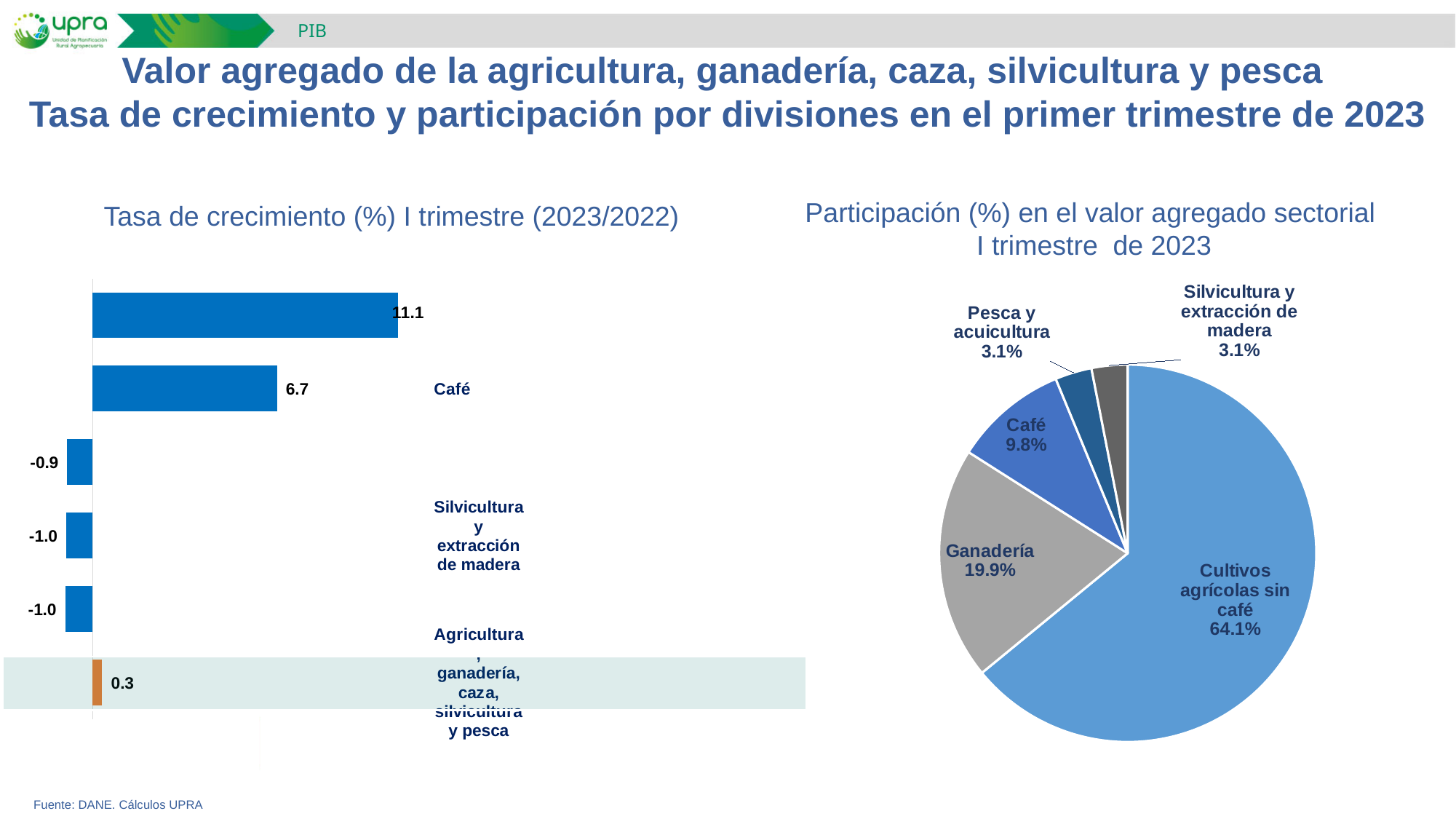
In the pie chart 'Participación (%) en el valor agregado sectorial I trimestre de 2023', what share does 'Cultivos agrícolas sin café' have? 64.1% In the pie chart 'Participación (%) en el valor agregado sectorial I trimestre de 2023', what is the share of 'Ganadería'? 19.9% In the pie chart 'Participación (%) en el valor agregado sectorial I trimestre de 2023', which category has the largest share? Cultivos agrícolas sin café In the pie chart 'Participación (%) en el valor agregado sectorial I trimestre de 2023', which has a larger share, 'Ganadería' or 'Café'? Ganadería In the pie chart 'Participación (%) en el valor agregado sectorial I trimestre de 2023', what is the difference in percentage points between 'Cultivos agrícolas sin café' and 'Ganadería'? 44.2 In the pie chart 'Participación (%) en el valor agregado sectorial I trimestre de 2023', how many slices are there? 5 In the bar chart 'Tasa de crecimiento (%) I trimestre (2023/2022)', what is the highest value shown? 11.1 What type of chart is the one on the left of the slide, titled 'Tasa de crecimiento (%) I trimestre (2023/2022)'? Bar chart In the bar chart 'Tasa de crecimiento (%) I trimestre (2023/2022)', what is the growth rate for 'Agricultura, ganadería, caza, silvicultura y pesca'? 0.3 In the bar chart 'Tasa de crecimiento (%) I trimestre (2023/2022)', what is the growth rate for 'Café'? 6.7 In the pie chart 'Participación (%) en el valor agregado sectorial I trimestre de 2023', what is the share of 'Pesca y acuicultura'? 3.1% In the bar chart 'Tasa de crecimiento (%) I trimestre (2023/2022)', how many bars are plotted? 6